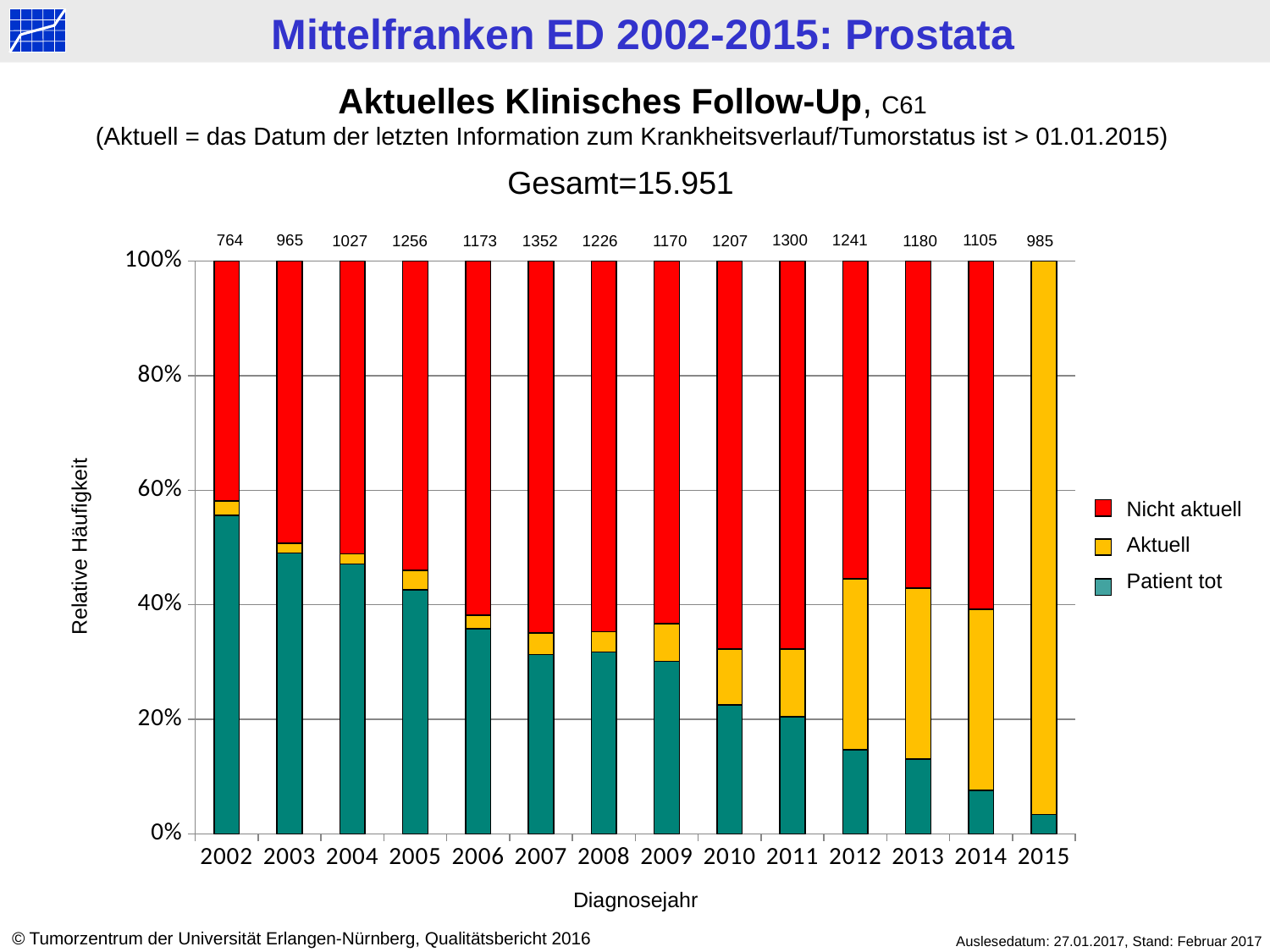
Is the share of 'Patient tot' for 2002 greater or less than 40%? greater How many diagnosis years are shown on the x axis? 14 Does the share of 'Patient tot' rise or fall from 2002 to 2015? fall How many series does the legend list? 3 What number is printed above the bar for 2007? 1352 Which year has the larger number printed above its bar, 2005 or 2011? 2011 Which diagnosis year has the lowest number printed above its bar? 2002 What number is printed above the bar for 2002? 764 Which diagnosis year has the highest number printed above its bar? 2007 What is the difference between the numbers printed above the bars for 2007 and 2002? 588 Is the share of 'Patient tot' for 2015 greater or less than 20%? less What kind of chart is shown on the slide? stacked bar chart